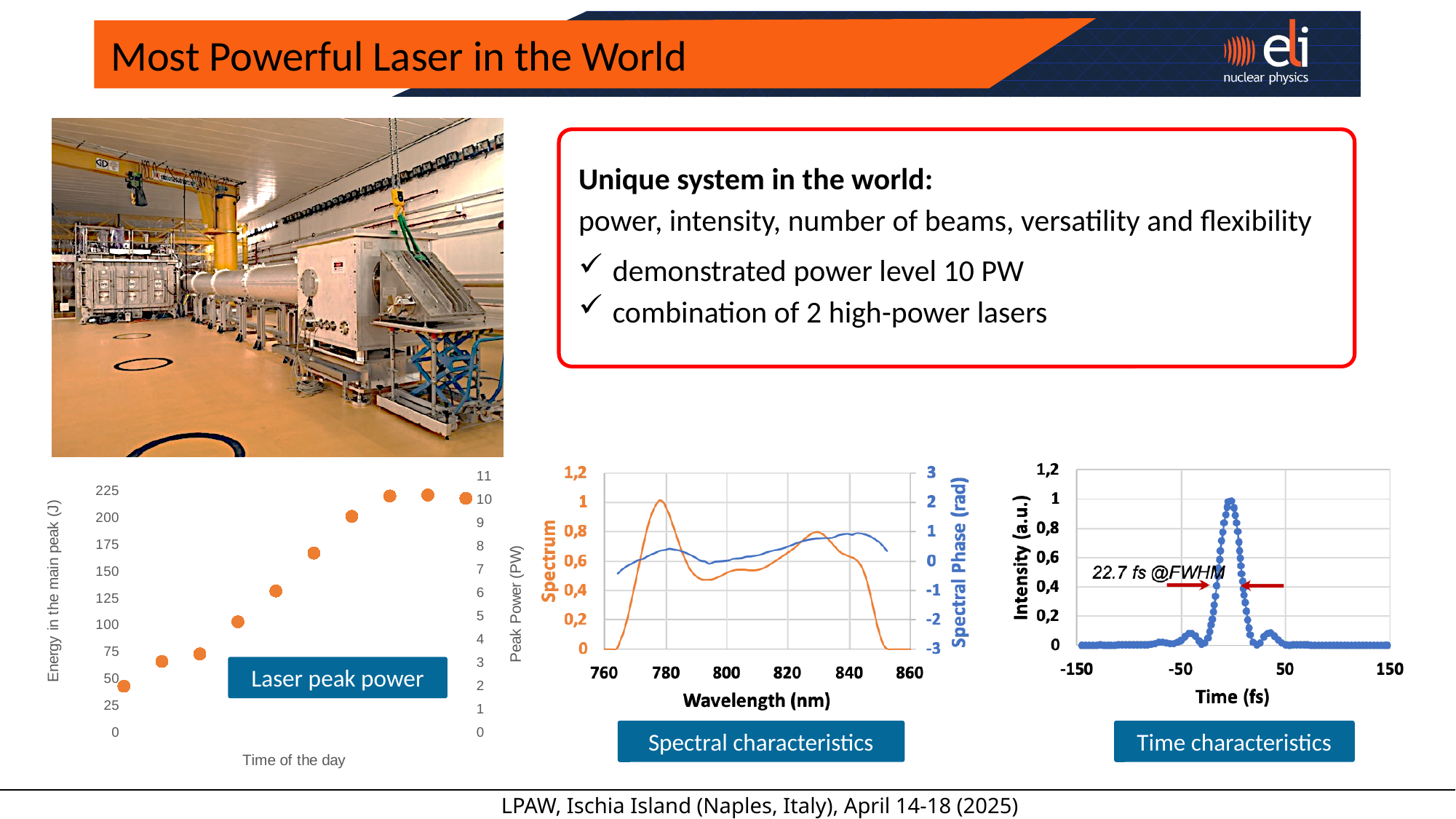
In the 'Time characteristics' chart, what pulse duration is annotated at FWHM? 22.7 fs In the 'Laser peak power' chart, is the energy of the fourth point greater or less than 125? less In the 'Laser peak power' chart, do the values rise or fall along the x axis (Time of the day)? rise In the 'Laser peak power' chart, is the energy of the last (rightmost) point greater or less than 200? greater What kind of chart is the 'Spectral characteristics' chart? line chart What kind of chart is the 'Laser peak power' chart? scatter chart In the 'Laser peak power' chart, what is the label of the left vertical axis? Energy in the main peak (J) In the 'Spectral characteristics' chart, how many series are plotted? 2 In the 'Time characteristics' chart, is the peak intensity at 0 fs greater or less than 0.8? greater In the 'Spectral characteristics' chart, what is the label of the horizontal axis? Wavelength (nm) In the 'Laser peak power' chart, how many data points are plotted? 10